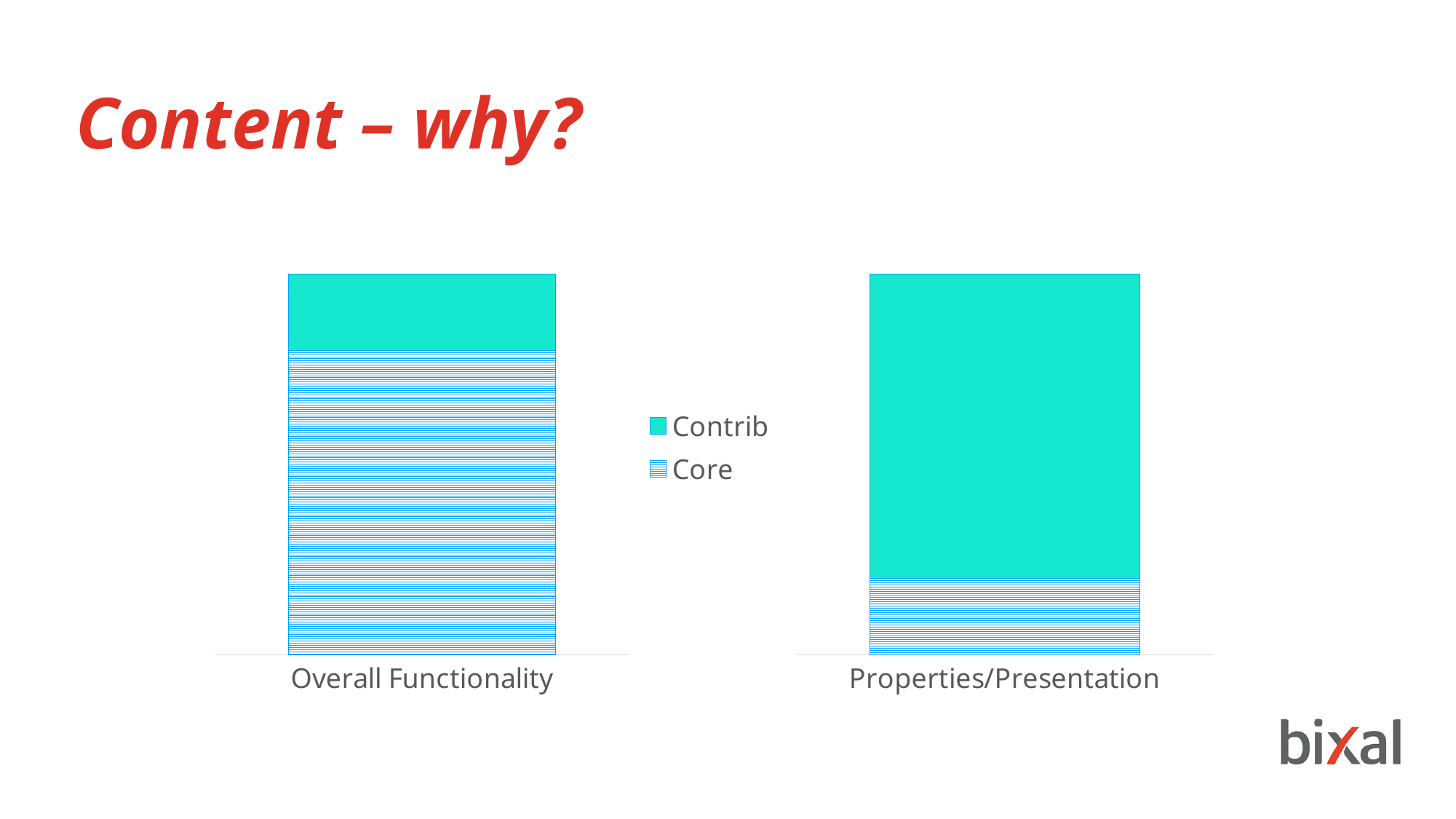
What is the title of the slide containing the chart? Content – why? For Properties/Presentation, which segment is larger, Contrib or Core? Contrib For Overall Functionality, which segment is larger, Contrib or Core? Core How many categories are shown on the x axis? 2 Which category has the largest Core share? Overall Functionality Which category has the larger Contrib segment, Overall Functionality or Properties/Presentation? Properties/Presentation How many series does the legend list? 2 Which series are listed in the legend? Contrib and Core Which category has the smallest Contrib share? Overall Functionality What kind of chart is shown on the slide? bar chart Which series is drawn with a striped pattern? Core